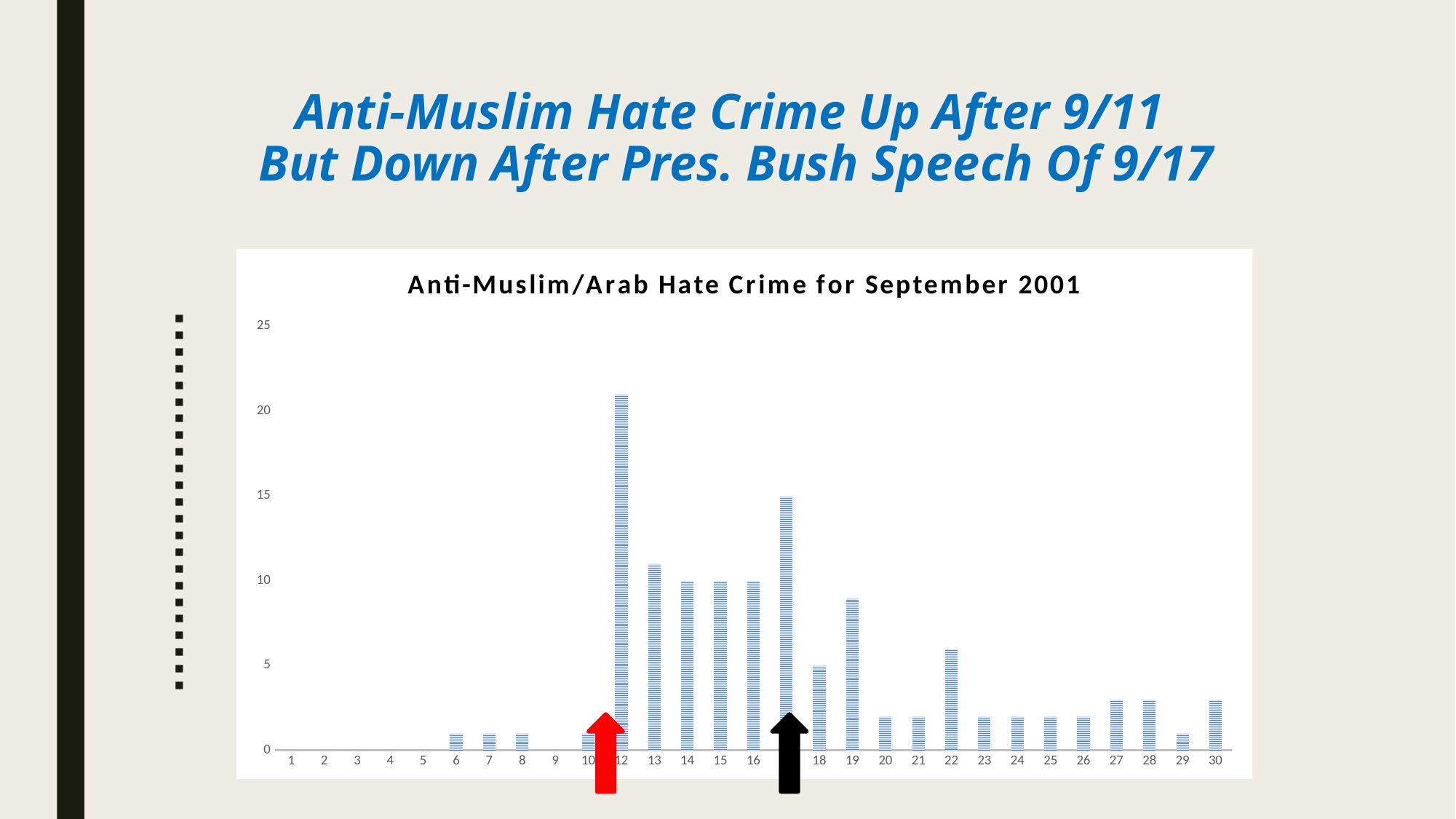
Is the value for day 22 greater or less than 5? greater Is the value for day 12 greater or less than 20? greater Is the value for day 20 greater or less than 5? less Which is larger, the value for day 13 or the value for day 19? day 13 What colours are the two arrows drawn below the x axis of the chart? red and black What is the title of the chart? Anti-Muslim/Arab Hate Crime for September 2001 How many days (categories) are shown along the x axis of the chart? 29 What kind of chart is shown on the slide? bar chart Which is larger, the value for day 12 or the value for day 17? day 12 Which day has the highest bar in the chart? 12